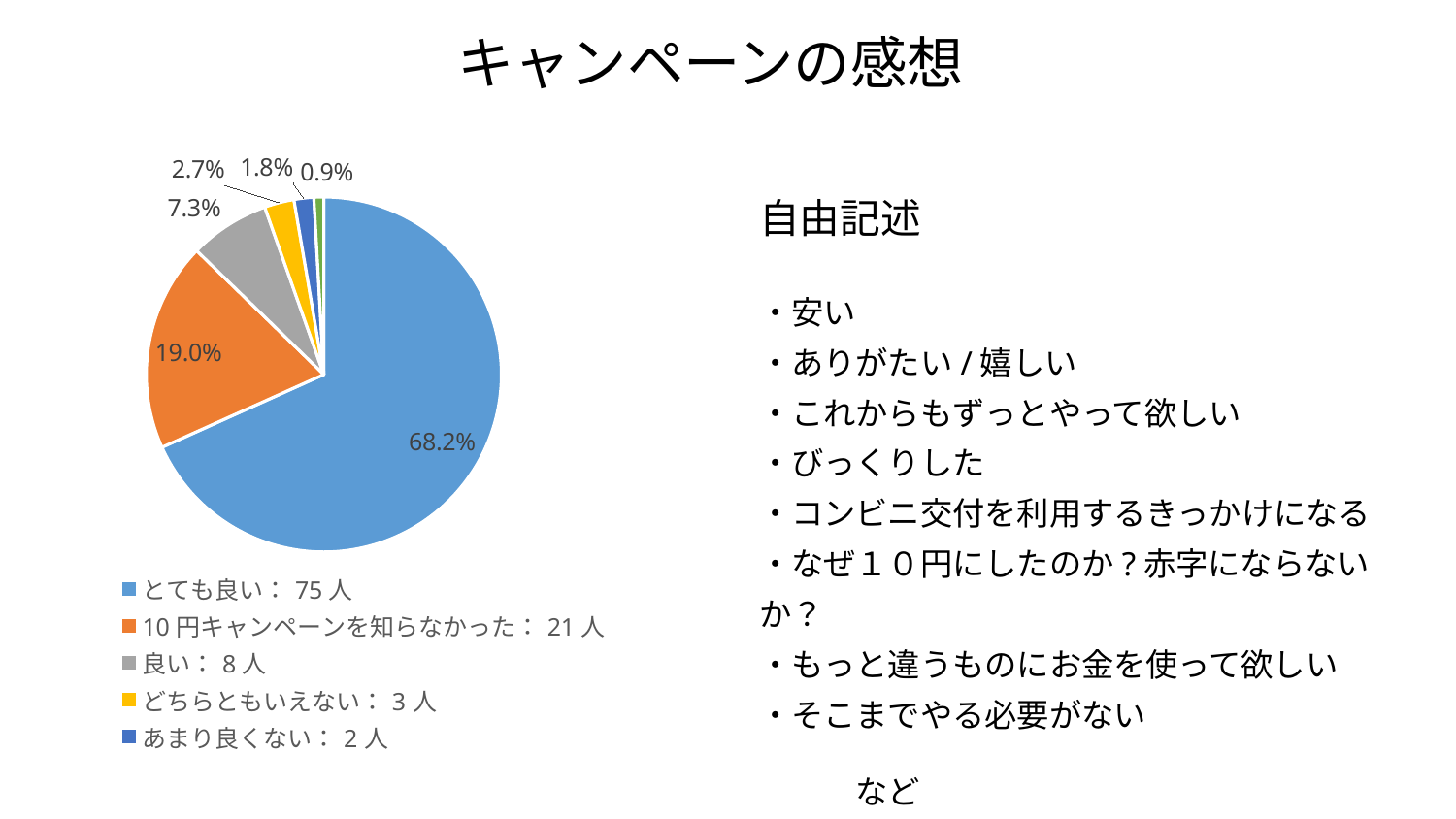
How many entries does the legend list? 5 Which is larger, the share for 良い or the share for どちらともいえない? 良い What is the difference in percentage points between the とても良い slice and the 10円キャンペーンを知らなかった slice? 49.2 percentage points What percentage of the pie does 良い represent? 7.3% What type of chart is shown on the slide? Pie chart How many people answered とても良い according to the legend? 75人 What percentage of the pie does とても良い represent? 68.2% What percentage of the pie does 10円キャンペーンを知らなかった represent? 19.0% What percentage of the pie does あまり良くない represent? 1.8% How many people answered どちらともいえない according to the legend? 3人 Which category has the largest share of the pie? とても良い What is the title of the chart? キャンペーンの感想